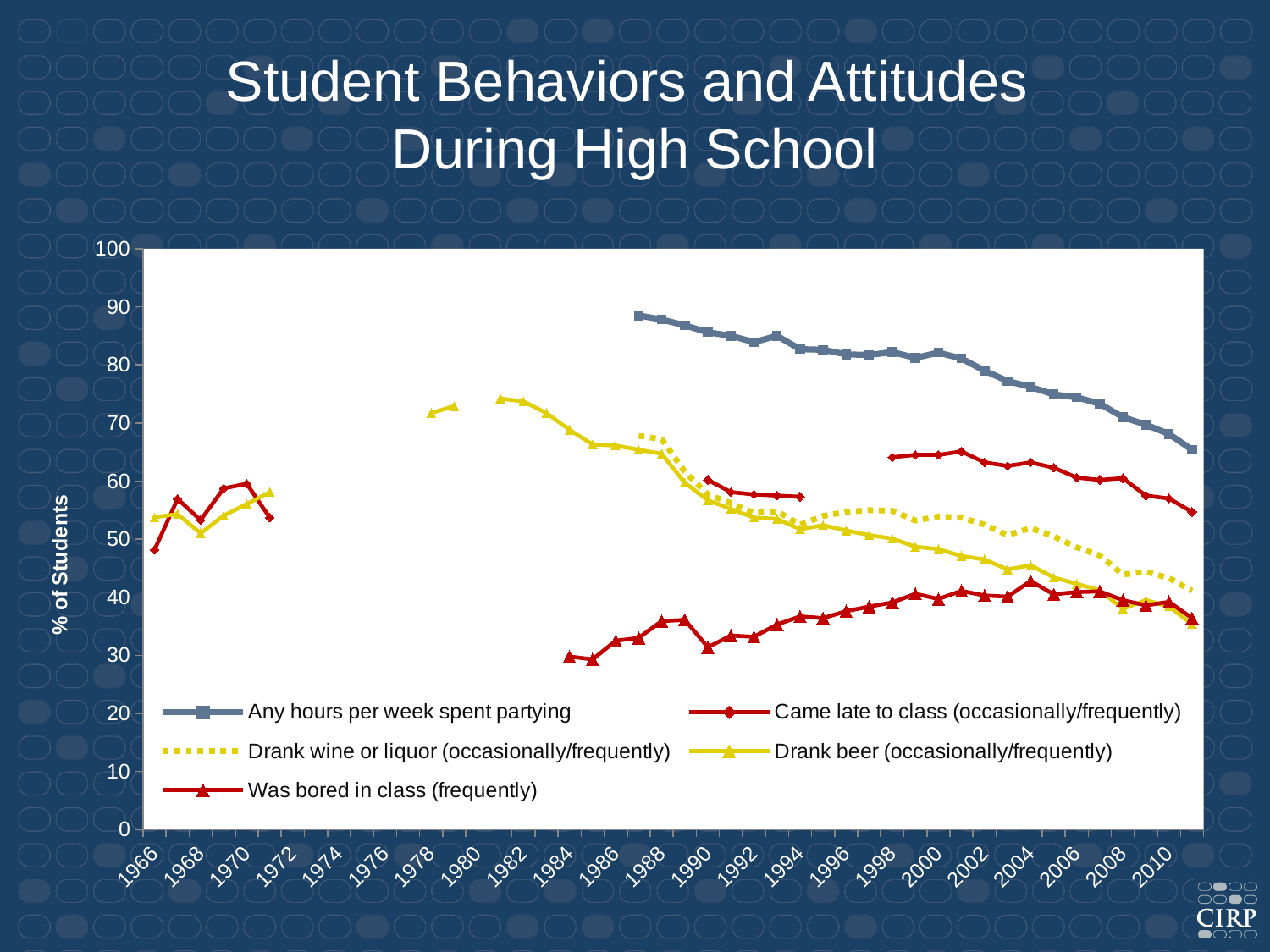
Is the value for 'Any hours per week spent partying' in 1988 greater or less than 80? greater Does the 'Was bored in class (frequently)' series rise or fall from 1984 to 2004? rise Is the value for 'Any hours per week spent partying' in 2010 greater or less than 60? greater What kind of chart is shown on the slide? line chart Is the value for 'Drank beer (occasionally/frequently)' in 1982 greater or less than 70? greater Does the 'Any hours per week spent partying' series rise or fall from 1988 to 2010? fall What is the title of the chart? Student Behaviors and Attitudes During High School In 2000, which is larger: 'Any hours per week spent partying' or 'Came late to class (occasionally/frequently)'? Any hours per week spent partying How many series does the legend list? 5 What is the label on the y axis? % of Students